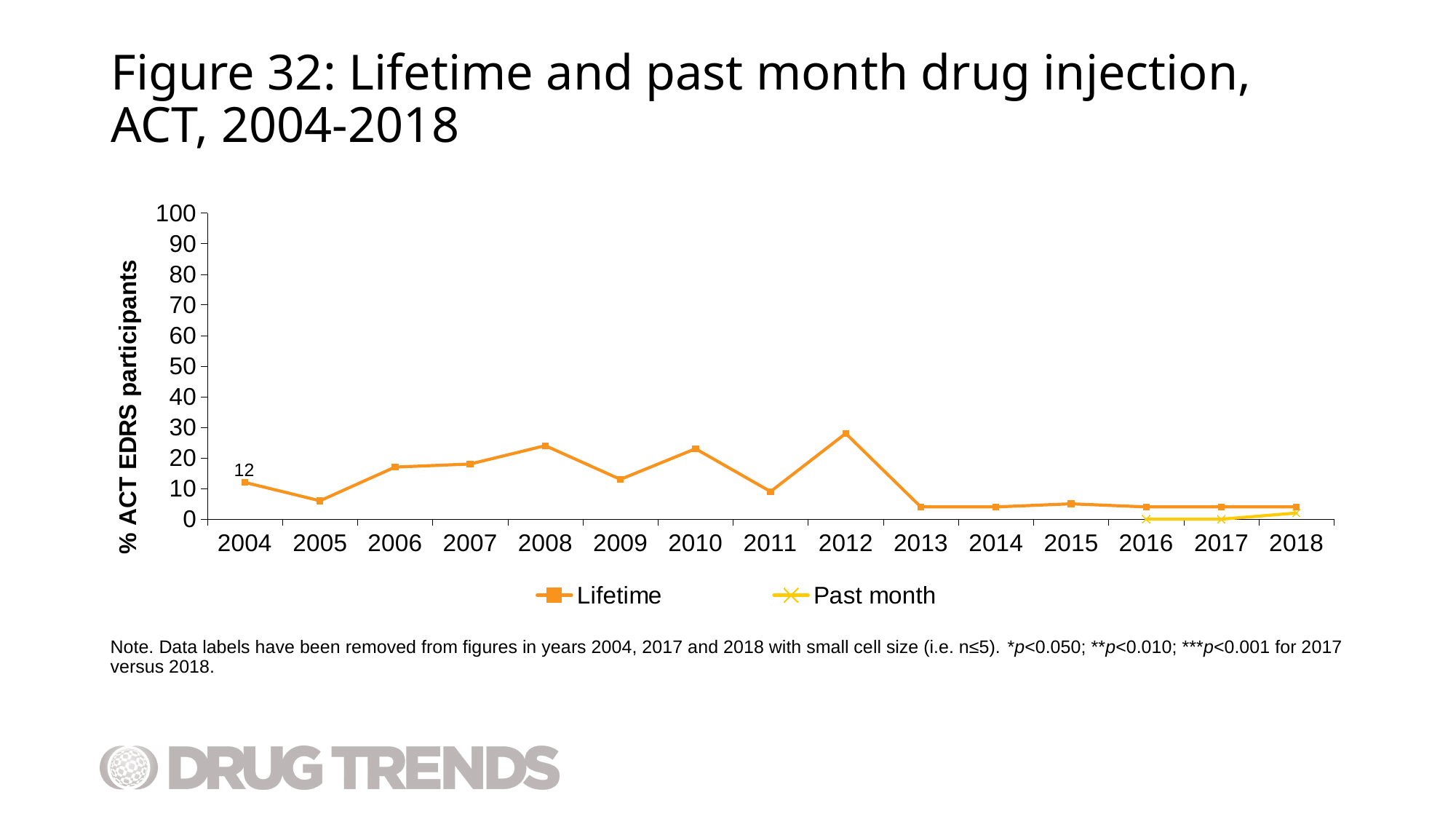
What is the Lifetime value for 2004? 12 How many years are shown on the x axis? 15 Is the Lifetime value for 2005 greater or less than 10? less Does the Lifetime series rise or fall from 2012 to 2013? fall What is the label on the y axis? % ACT EDRS participants How many series does the legend list? 2 What are the two series named in the legend? Lifetime and Past month Is the Lifetime value for 2012 greater or less than 20? greater What kind of chart is shown on the slide? line chart Which year has the larger Lifetime value, 2010 or 2011? 2010 In which year is the Lifetime series at its highest? 2012 Is the Lifetime value for 2013 greater or less than 10? less